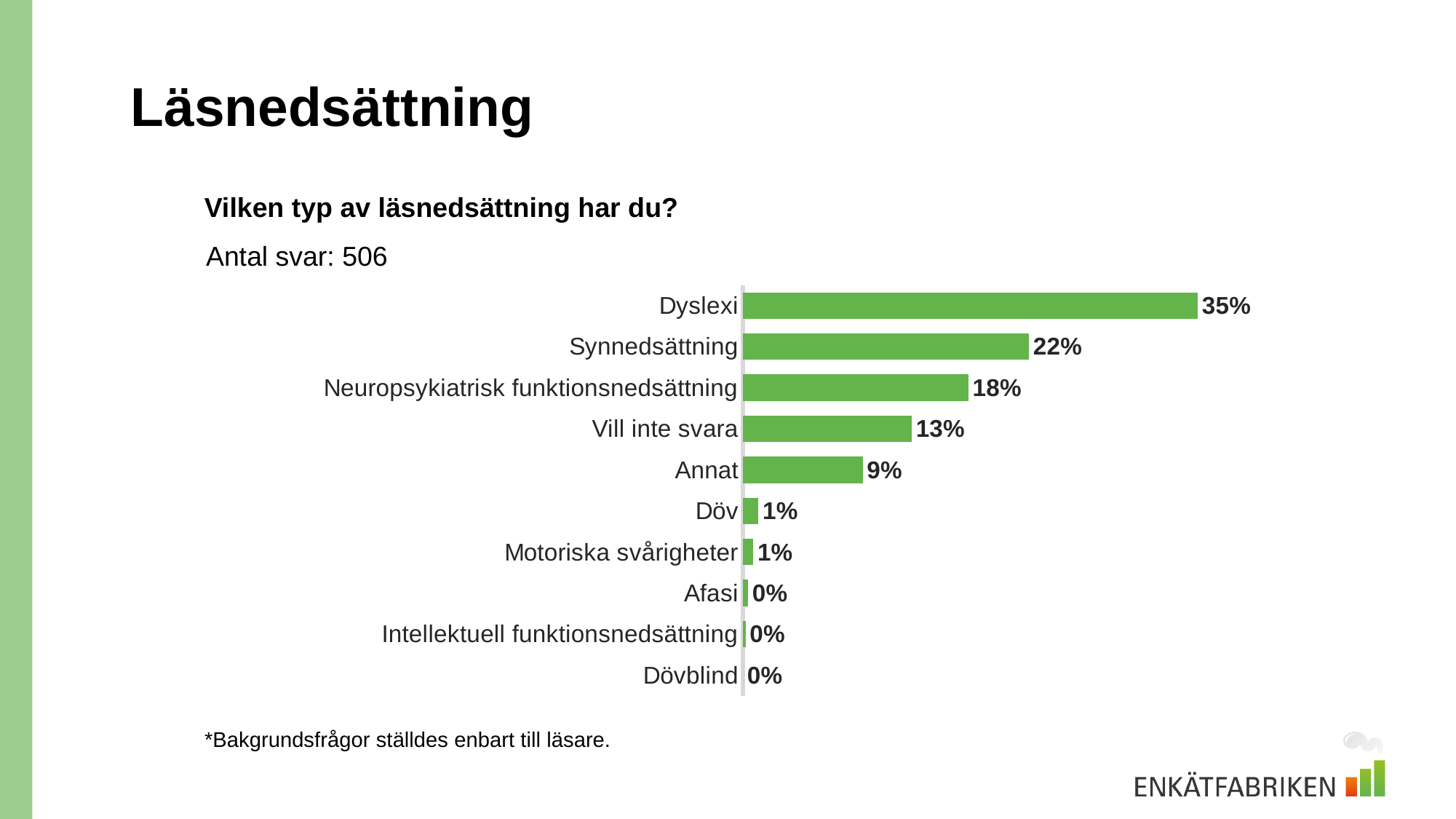
Which is larger, the value for Vill inte svara or the value for Annat? Vill inte svara What is the value for Vill inte svara? 13% How many categories are shown in the chart? 10 What percentage is shown for Annat? 9% What kind of chart is shown on the slide? Bar chart What is the value shown for Synnedsättning? 22% What is the difference between the values for Neuropsykiatrisk funktionsnedsättning and Annat? 9% What percentage of respondents reported Dyslexi? 35% Which category has the highest value? Dyslexi What percentage is shown for Neuropsykiatrisk funktionsnedsättning? 18% How many responses (Antal svar) does the slide report for this question? 506 What is the difference between the values for Dyslexi and Synnedsättning? 13%